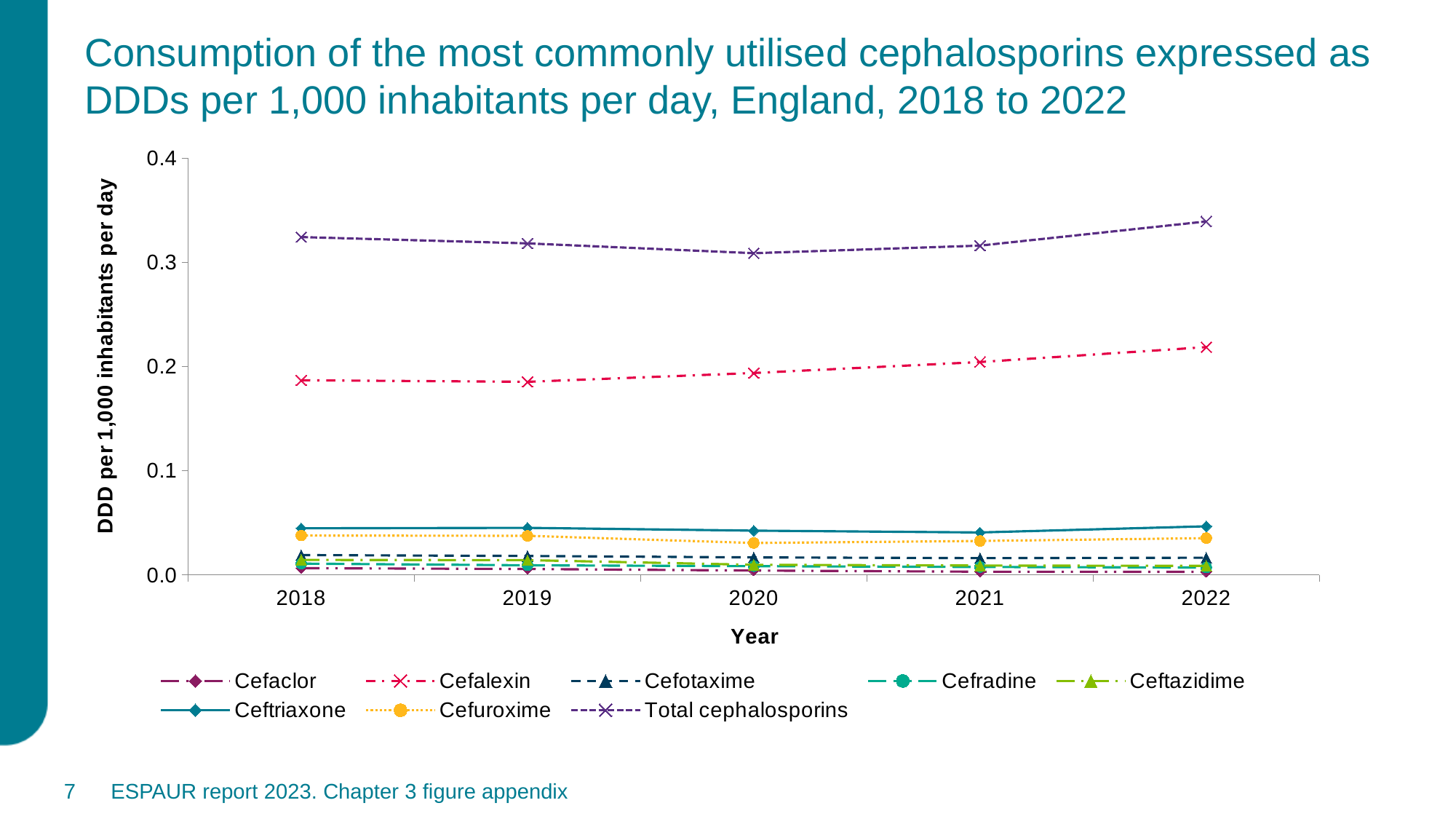
Which series has the highest values across all years? Total cephalosporins How many years are plotted along the x axis? 5 How many series does the legend list? 8 Is the value for Cefalexin in 2018 greater or less than 0.2? less Is the value for Total cephalosporins in 2022 greater or less than 0.3? greater Does the Cefalexin line rise or fall from 2018 to 2022? Rises Is the value for Ceftriaxone in 2020 greater or less than 0.1? less In 2022, which is larger: Cefalexin or Ceftriaxone? Cefalexin What is the label on the x axis? Year What kind of chart is shown on the slide? Line chart What is the label on the y axis? DDD per 1,000 inhabitants per day